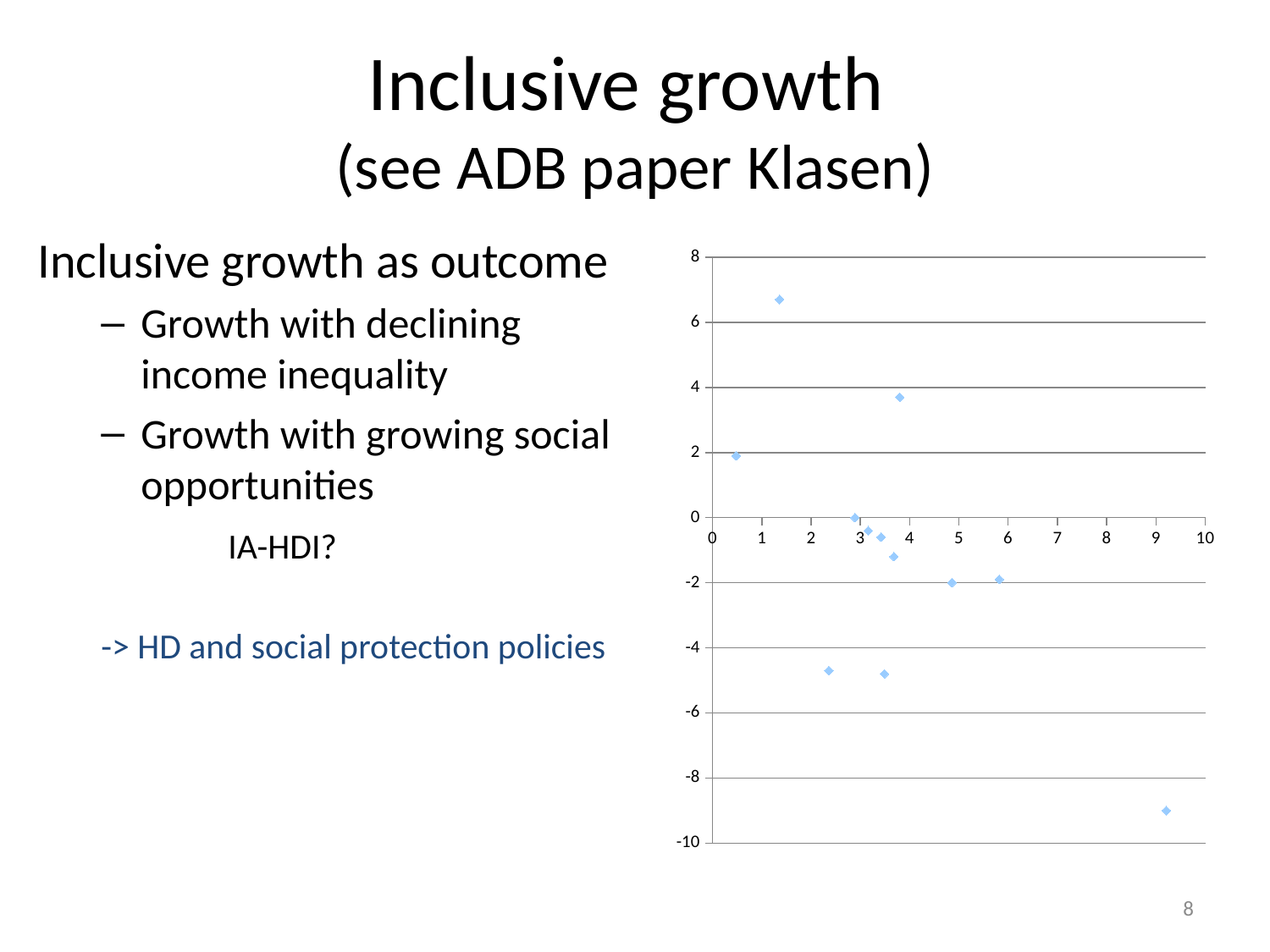
Does the chart show a legend? No How many data points are plotted in the scatter chart? 12 How many points in the chart have a vertical value below -4? 3 What kind of chart is shown on the slide? scatter chart Is the vertical value of the leftmost point in the chart greater or less than 0? greater Is the horizontal value of the highest point in the chart greater or less than 2? less Which point has the larger vertical value: the one near x = 1.4 or the one near x = 3.8? the one near x = 1.4 Is the horizontal value of the rightmost point in the chart greater or less than 9? greater What is the highest value shown on the vertical axis of the chart? 8 What is the lowest value shown on the vertical axis of the chart? -10